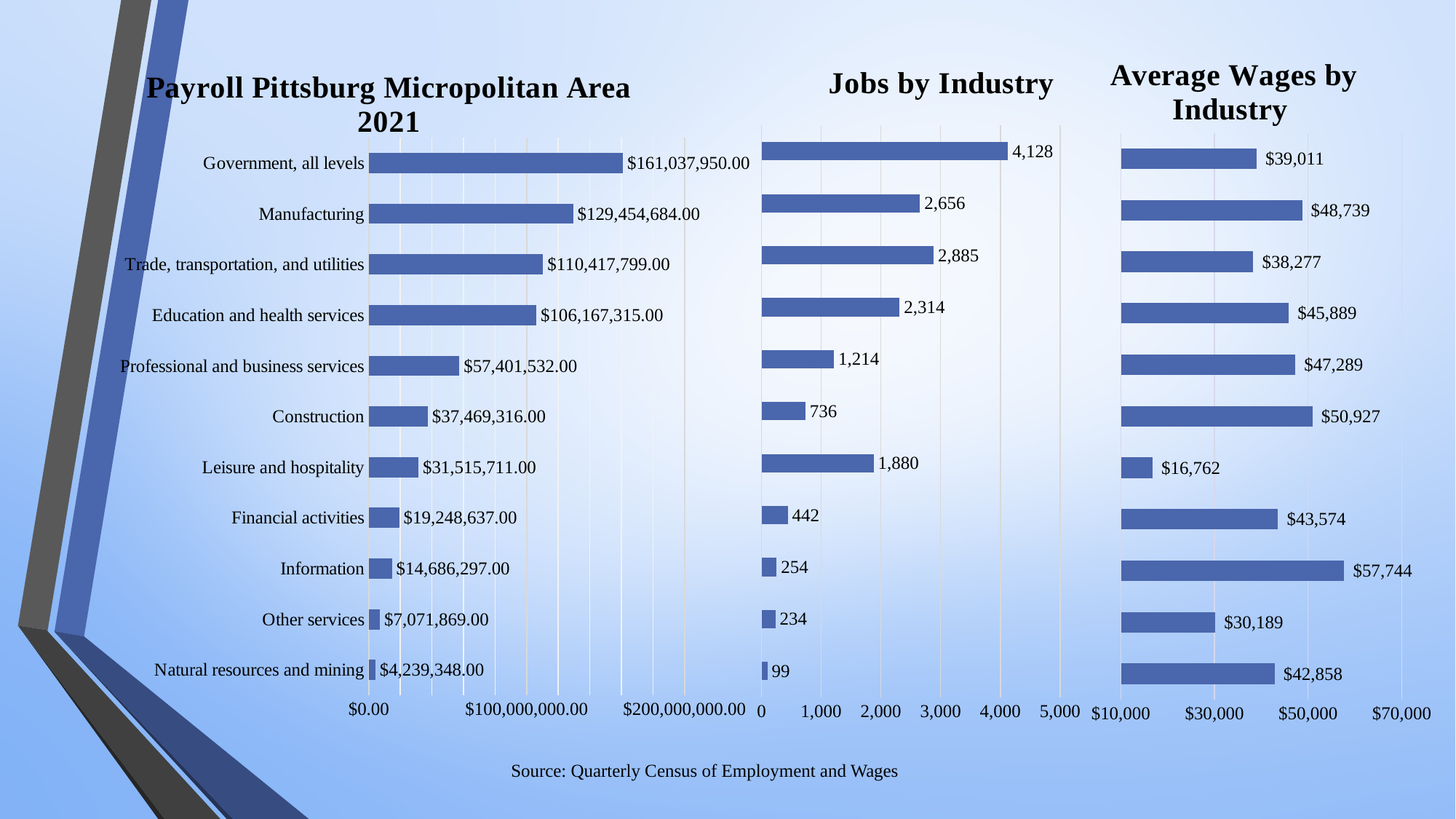
In the 'Jobs by Industry' chart, which has more jobs: Manufacturing or Trade, transportation, and utilities? Trade, transportation, and utilities In the 'Jobs by Industry' chart, how many jobs are shown for Leisure and hospitality? 1,880 What type of chart is the 'Average Wages by Industry' chart? Bar chart In the 'Average Wages by Industry' chart, which industry has the highest average wage? Information In the 'Payroll Pittsburg Micropolitan Area 2021' chart, what is the payroll value for Manufacturing? $129,454,684.00 In the 'Average Wages by Industry' chart, what is the average wage for Construction? $50,927 In the 'Jobs by Industry' chart, which industry has the fewest jobs? Natural resources and mining In the 'Average Wages by Industry' chart, which industry has the lowest average wage? Leisure and hospitality In the 'Average Wages by Industry' chart, what is the difference between the average wage for Information and the average wage for Other services? $27,555 In the 'Jobs by Industry' chart, what is the difference in jobs between Government, all levels and Manufacturing? 1,472 In the 'Payroll Pittsburg Micropolitan Area 2021' chart, is the payroll for Government, all levels greater or less than $100,000,000.00? greater How many industries are listed in the 'Jobs by Industry' chart? 11